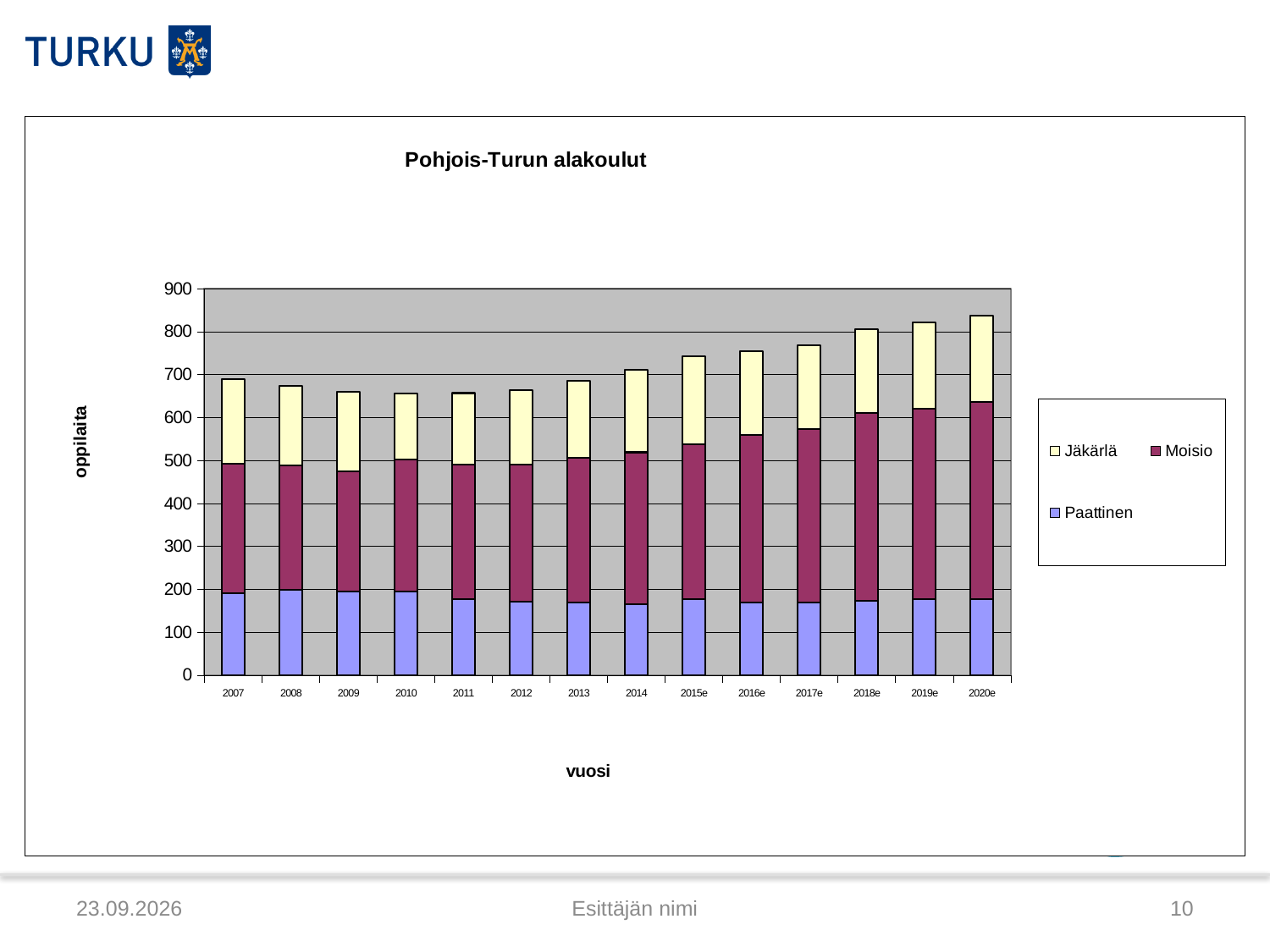
Which series forms the largest segment of the 2020e bar? Moisio What is the title of the chart? Pohjois-Turun alakoulut Is the total for 2007 greater or less than 700? less Is the total for 2016e greater or less than 700? greater Is the total for 2020e greater or less than 800? greater How many years are shown on the x axis? 14 What kind of chart is shown on the slide? Stacked bar chart Which is larger, the total for 2020e or the total for 2007? 2020e Which year has the highest total bar? 2020e How many series does the legend list? 3 Do the total bars rise or fall from 2013 to 2020e? rise What is the label of the y axis? oppilaita